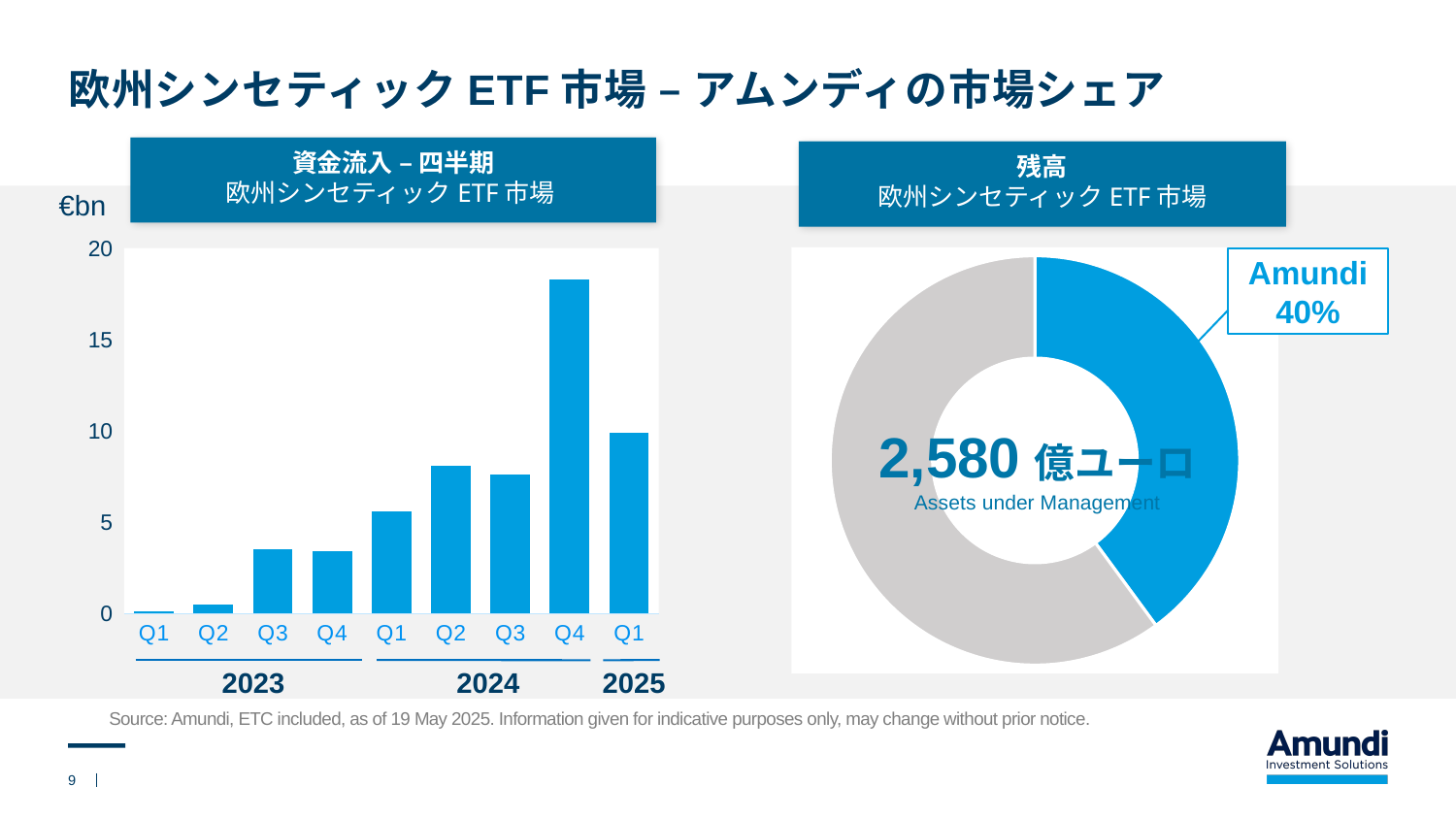
On the left chart (資金流入 – 四半期), which quarter has the lowest inflow? Q1 2023 On the left chart (資金流入 – 四半期), which quarter has the highest inflow? Q4 2024 On the right chart (残高), what kind of chart is shown? donut (pie) chart On the left chart (資金流入 – 四半期), which is larger, the inflow for Q4 2024 or for Q1 2025? Q4 2024 On the left chart (資金流入 – 四半期), is the value for Q2 2024 greater or less than 5? greater On the left chart (資金流入 – 四半期), is the value for Q3 2023 greater or less than 5? less On the left chart (資金流入 – 四半期), is the value for Q4 2024 greater or less than 15? greater On the left chart (資金流入 – 四半期), what unit is shown for the y axis? €bn On the left chart (資金流入 – 四半期), what kind of chart is shown? bar chart On the left chart (資金流入 – 四半期), how many quarterly bars are plotted? 9 On the right chart (残高), what share of the market does Amundi hold? 40% On the right chart (残高), what total assets under management figure is shown in the centre? 2,580 億ユーロ